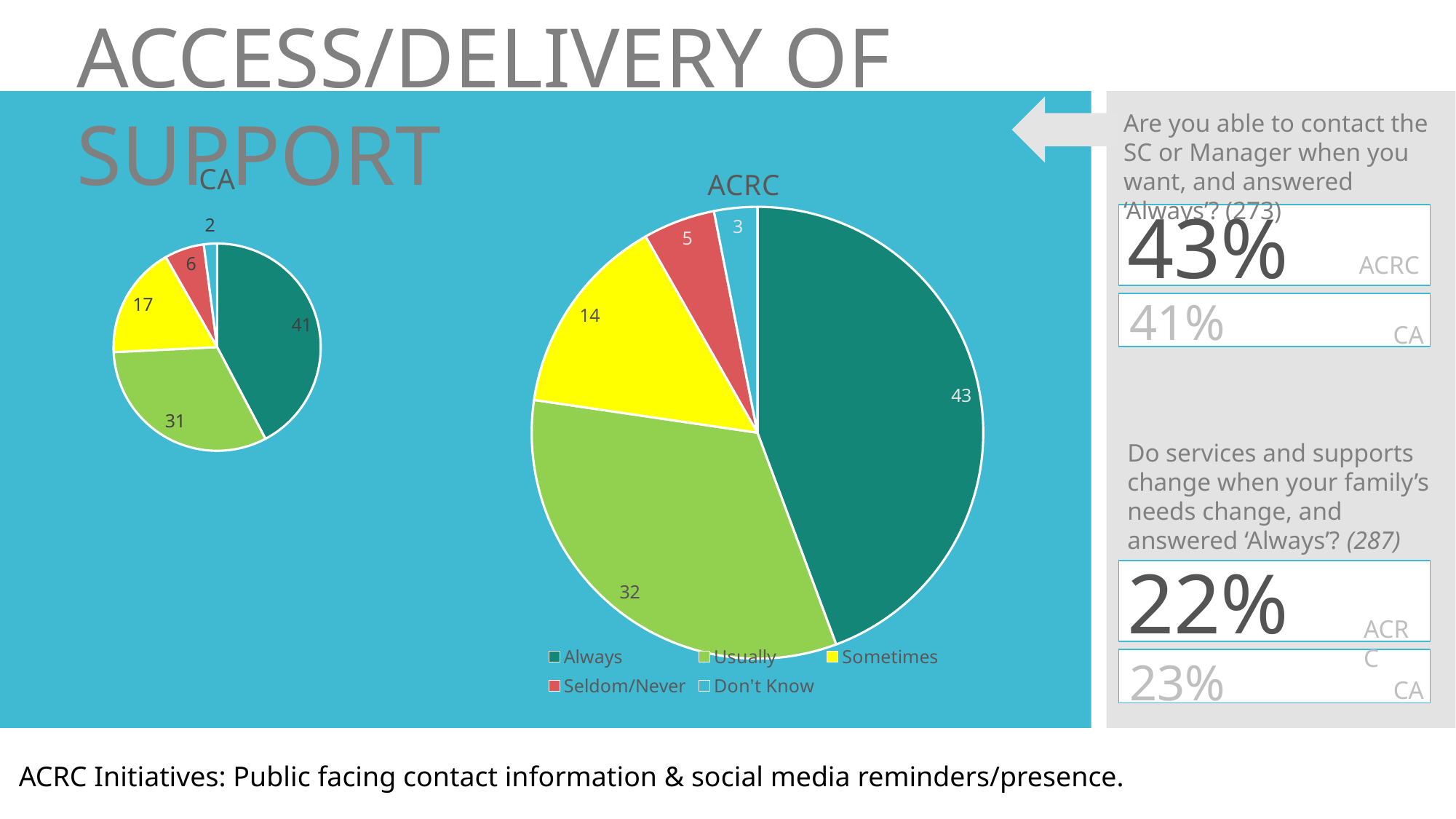
In the ACRC pie chart, what is the difference between the Always and Usually values? 11 How many entries does the legend list? 5 Which is larger: the Sometimes value in the CA pie chart or the Sometimes value in the ACRC pie chart? CA In the ACRC pie chart, what is the value for Always? 43 In the CA pie chart, what is the value for Seldom/Never? 6 What type of chart is used for the CA data? Pie chart In the ACRC pie chart, which category has the largest slice? Always In the ACRC pie chart, what is the value for Don't Know? 3 How many slices does the ACRC pie chart have? 5 In the CA pie chart, what is the value for Usually? 31 In the ACRC pie chart, what is the value for Sometimes? 14 In the CA pie chart, which category has the smallest slice? Don't Know